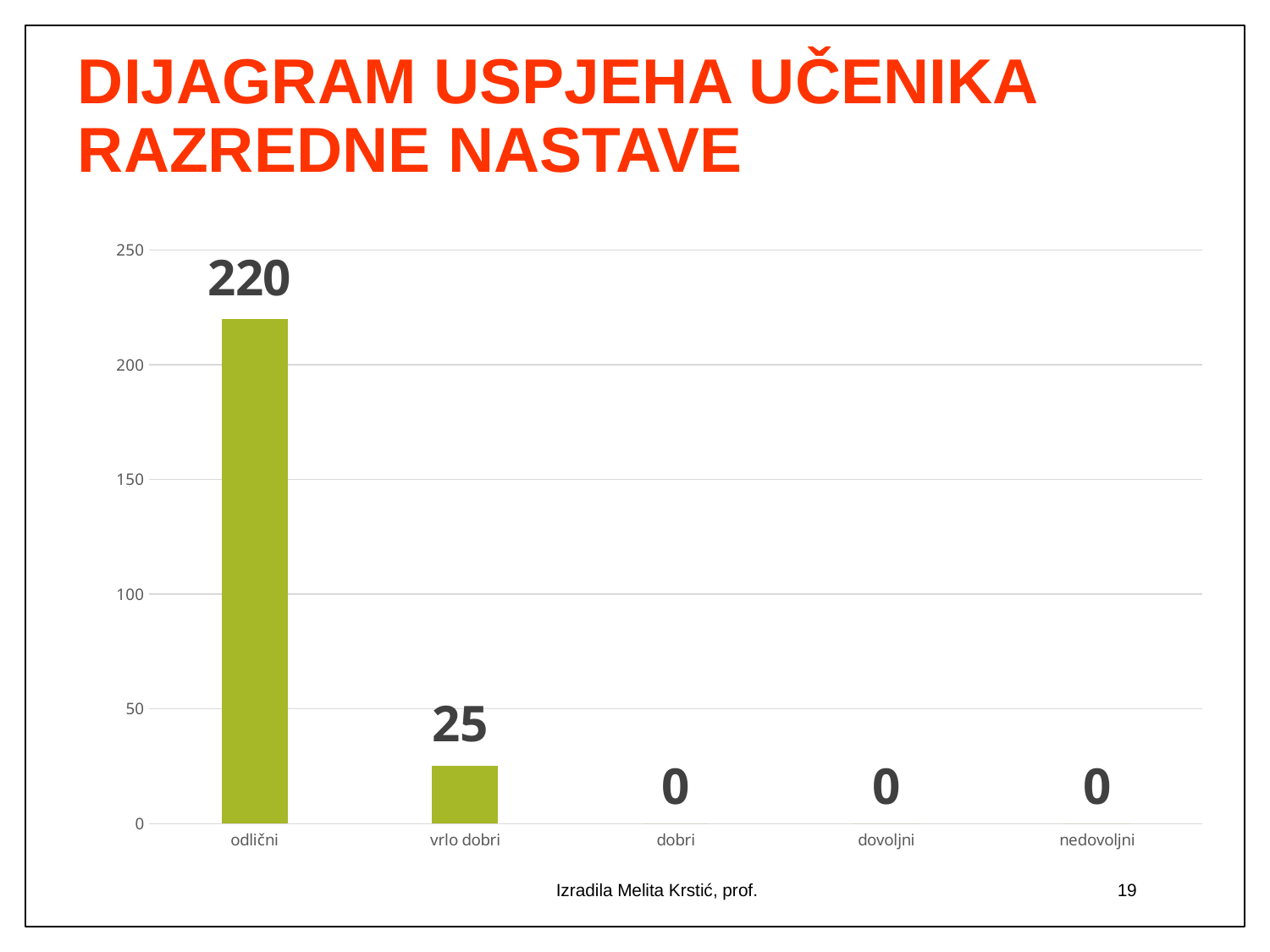
Is the value for vrlo dobri greater or less than 50? less What is the title of the slide containing the chart? DIJAGRAM USPJEHA UČENIKA RAZREDNE NASTAVE Is the value for odlični greater or less than 200? greater Do the values rise or fall from left to right along the x axis? fall What is the value for vrlo dobri? 25 What is the value for dobri? 0 Which is larger, the value for odlični or the value for vrlo dobri? odlični How many categories are shown on the x axis? 5 What kind of chart is shown on the slide? bar chart What is the difference between the values for odlični and vrlo dobri? 195 What is the value for odlični? 220 Which category has the highest value? odlični